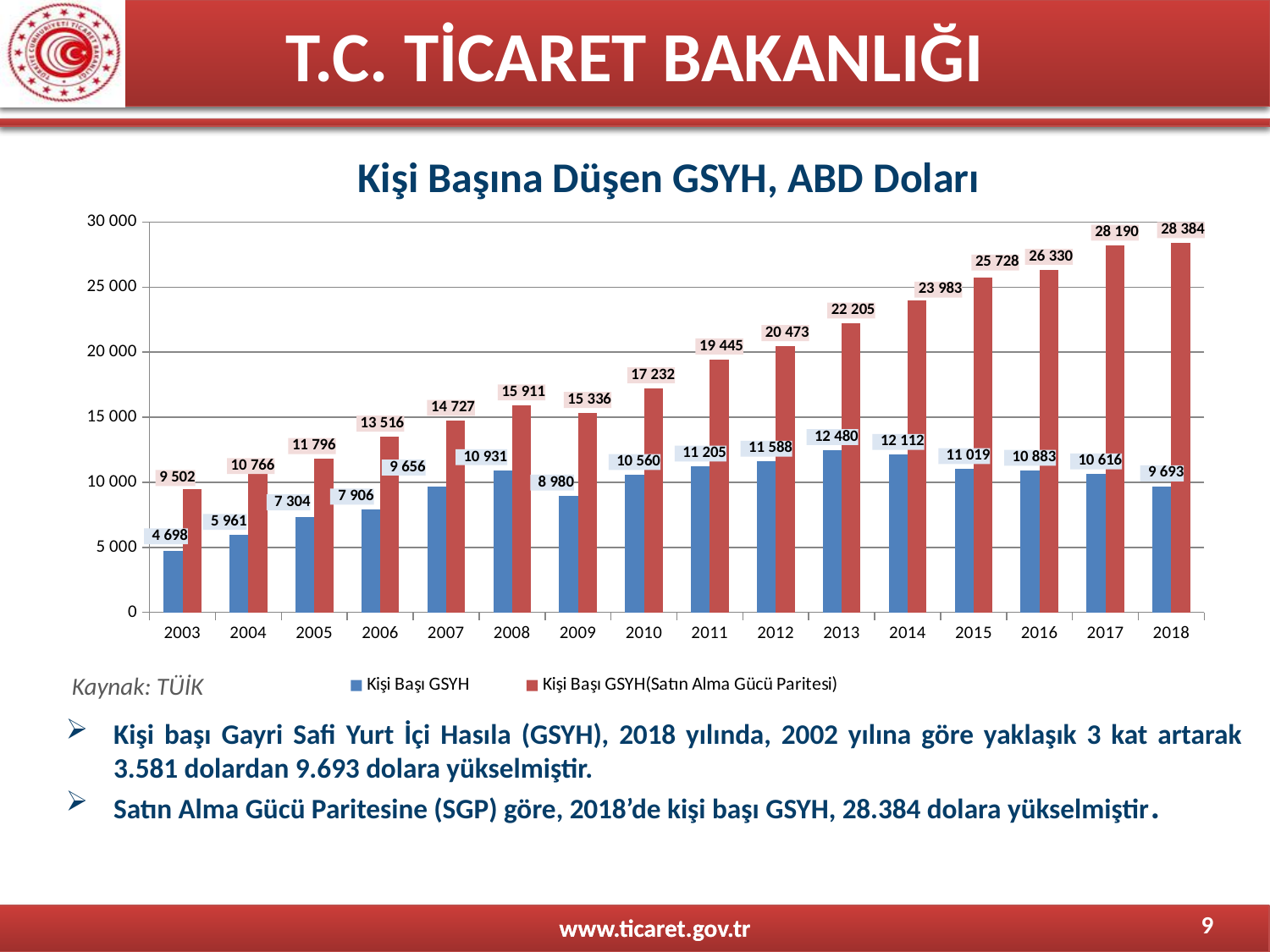
In which year is Kişi Başı GSYH highest? 2013 What is the value of Kişi Başı GSYH(Satın Alma Gücü Paritesi) for 2010? 17 232 In which year is Kişi Başı GSYH(Satın Alma Gücü Paritesi) highest? 2018 How many series does the legend list? 2 Which is larger: Kişi Başı GSYH in 2008 or in 2009? 2008 What type of chart is shown on the slide? Bar chart In which year is Kişi Başı GSYH lowest? 2003 How many years are shown on the x axis? 16 What is the value of Kişi Başı GSYH for 2013? 12 480 Does Kişi Başı GSYH(Satın Alma Gücü Paritesi) generally rise or fall from 2003 to 2018? Rise What is the title of the chart? Kişi Başına Düşen GSYH, ABD Doları What is the difference between Kişi Başı GSYH(Satın Alma Gücü Paritesi) and Kişi Başı GSYH in 2018? 18 691